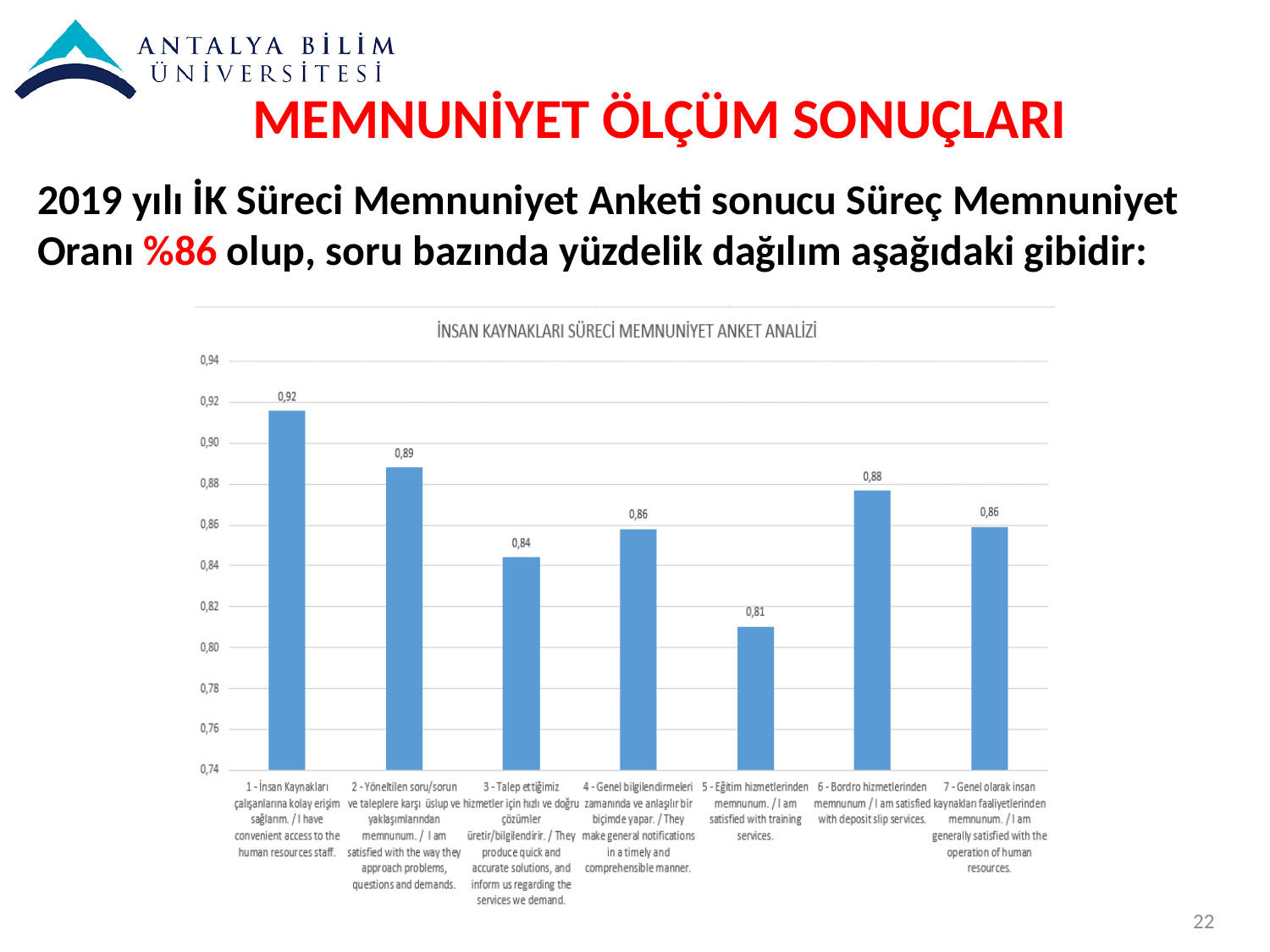
Is the value for category 3 (Talep ettiğimiz hizmetler) greater or less than 0,86? less Which category has the lowest value? 5 - Eğitim hizmetlerinden memnunum What is the value for category 6 (Bordro hizmetlerinden memnunum)? 0,88 What is the value for category 5 (Eğitim hizmetlerinden memnunum)? 0,81 Which is larger, the value for category 2 or the value for category 3? Category 2 (0,89) What is the difference between the values for category 1 and category 5? 0,11 Which category has the highest value? 1 - İnsan Kaynakları çalışanlarına kolay erişim sağlarım What is the title of the chart? İNSAN KAYNAKLARI SÜRECİ MEMNUNİYET ANKET ANALİZİ What is the value for category 1 (İnsan Kaynakları çalışanlarına kolay erişim sağlarım)? 0,92 How many categories (questions) are plotted in the chart? 7 Which two categories share the same value of 0,86? Category 4 and category 7 What kind of chart is shown on the slide? Bar chart